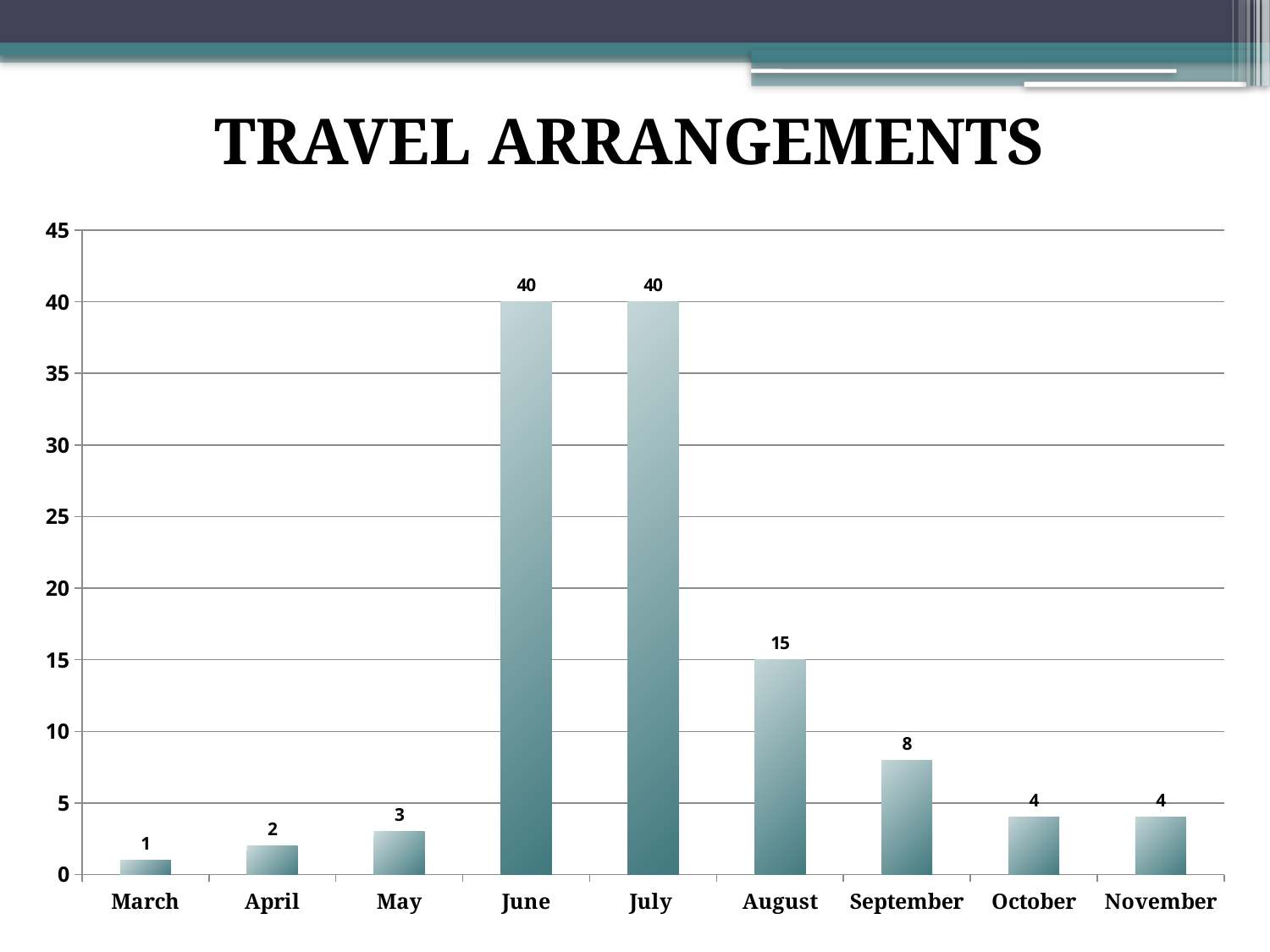
What is the value for September? 8 What is the difference between the values for August and September? 7 What is the value for August? 15 How many months are shown on the x axis? 9 Do the values rise or fall from July to November? Fall Is the value for August greater or less than 10? greater What is the difference between the values for June and August? 25 Which is larger, the value for May or the value for October? October What kind of chart is shown on the slide? Bar chart What is the value for March? 1 What is the title of the slide? TRAVEL ARRANGEMENTS Which month has the lowest value? March